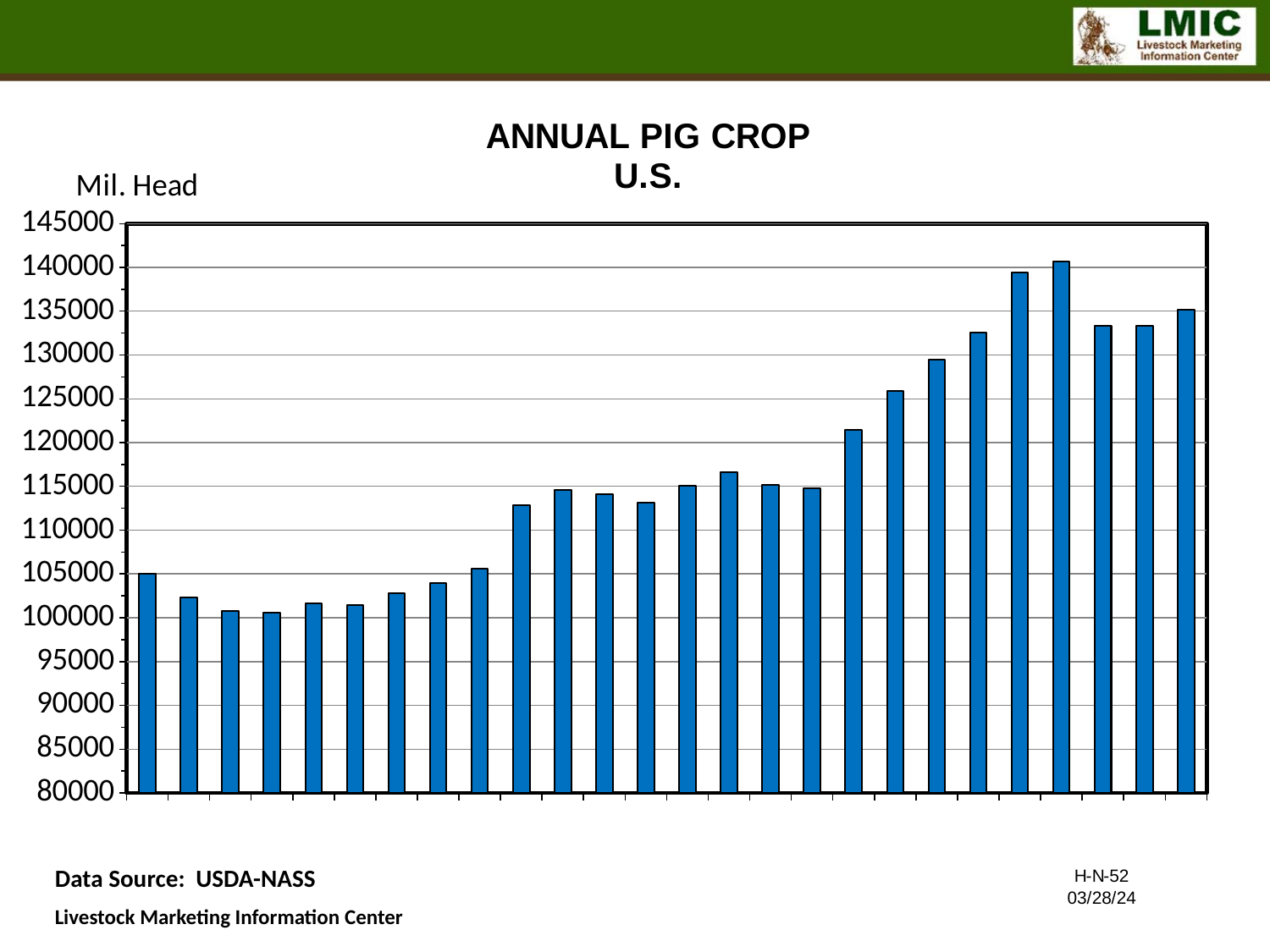
Is the value of the last (rightmost) bar greater or less than 130000? greater What is the title of the chart? ANNUAL PIG CROP U.S. Which is larger, the value of the leftmost bar or the value of the rightmost bar? the rightmost bar How many bars are plotted in the chart? 26 What unit label is shown above the vertical axis? Mil. Head Is the value of the shortest bar greater or less than 105000? less Is the value of the tallest bar greater or less than 135000? greater What kind of chart is shown on the slide? bar chart Is the tallest bar located in the left half or the right half of the chart? right half Do the bar values generally rise or fall from left to right across the chart? rise